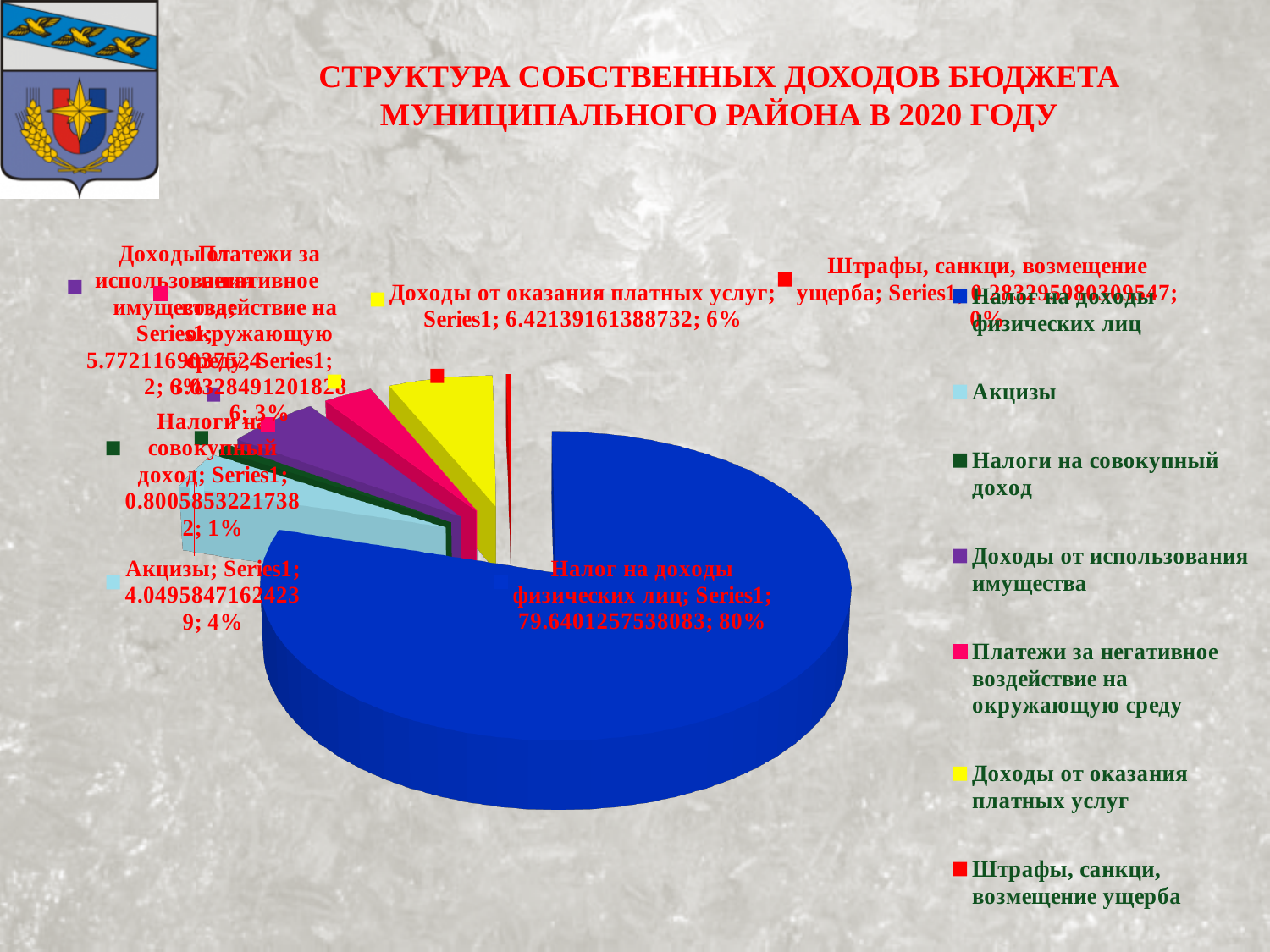
What percentage share is shown for Штрафы, санкции, возмещение ущерба? 0% What kind of chart is shown on the slide? Pie chart How many categories does the legend of the pie chart list? 7 What percentage share is shown for Доходы от оказания платных услуг? 6% Which category has the largest share of the pie? Налог на доходы физических лиц What percentage share is shown for Акцизы? 4% Which category has the smallest share of the pie? Штрафы, санкции, возмещение ущерба What is the title of the chart on the slide? СТРУКТУРА СОБСТВЕННЫХ ДОХОДОВ БЮДЖЕТА МУНИЦИПАЛЬНОГО РАЙОНА В 2020 ГОДУ What colour is the slice for Налог на доходы физических лиц? Blue Which has a larger share: Акцизы or Доходы от оказания платных услуг? Доходы от оказания платных услуг